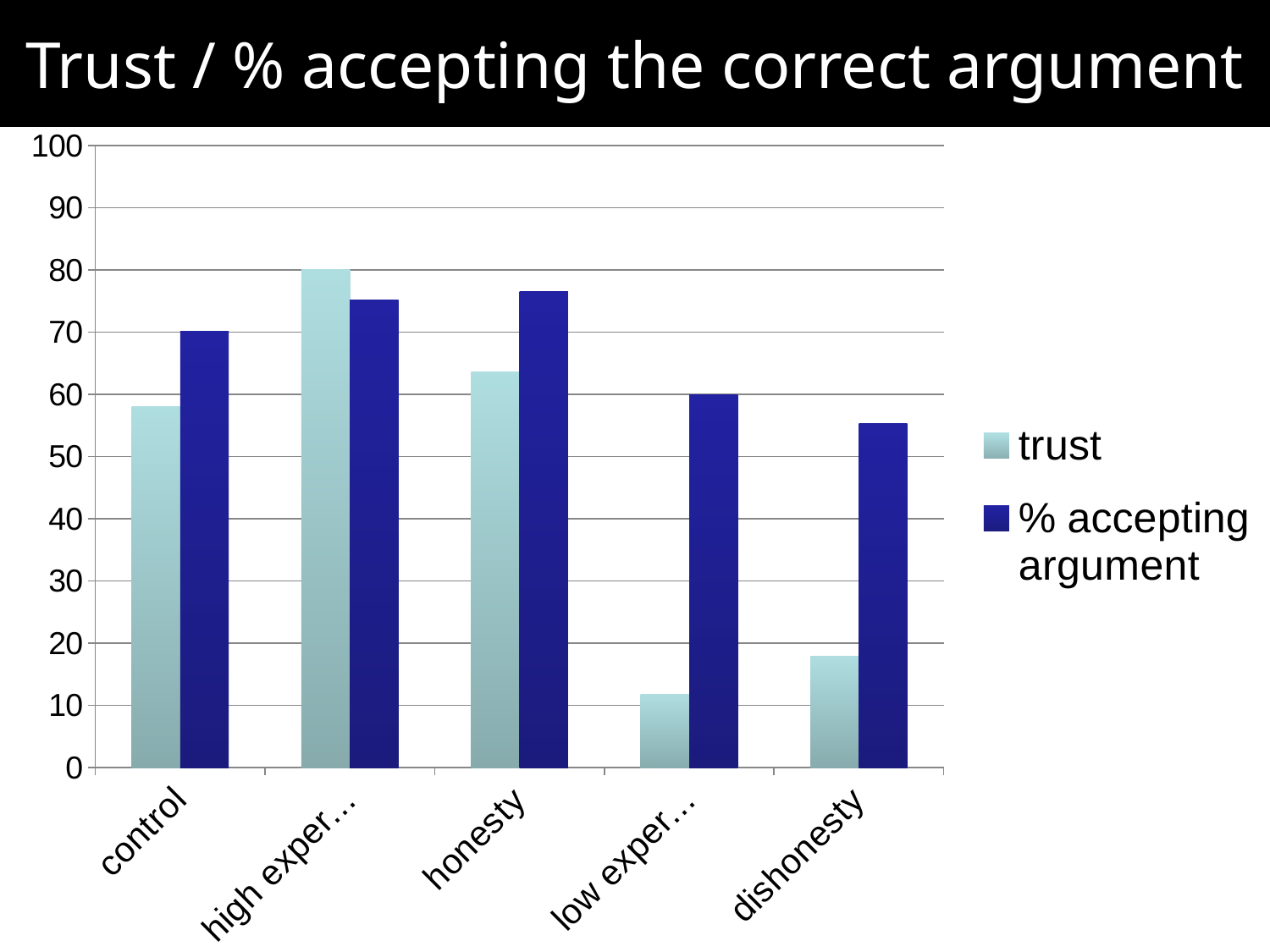
How many series does the legend list? 2 Is the % accepting argument value for honesty greater or less than 70? greater What are the two series named in the legend? trust and % accepting argument Is the trust value for dishonesty greater or less than 30? less What kind of chart is shown on the slide? bar chart Is the trust value for control greater or less than 50? greater Which category has the lowest % accepting argument value? dishonesty For the control category, which is larger: trust or % accepting argument? % accepting argument Which has the larger trust value: control or honesty? honesty What is the title of the chart? Trust / % accepting the correct argument How many categories are shown on the x axis? 5